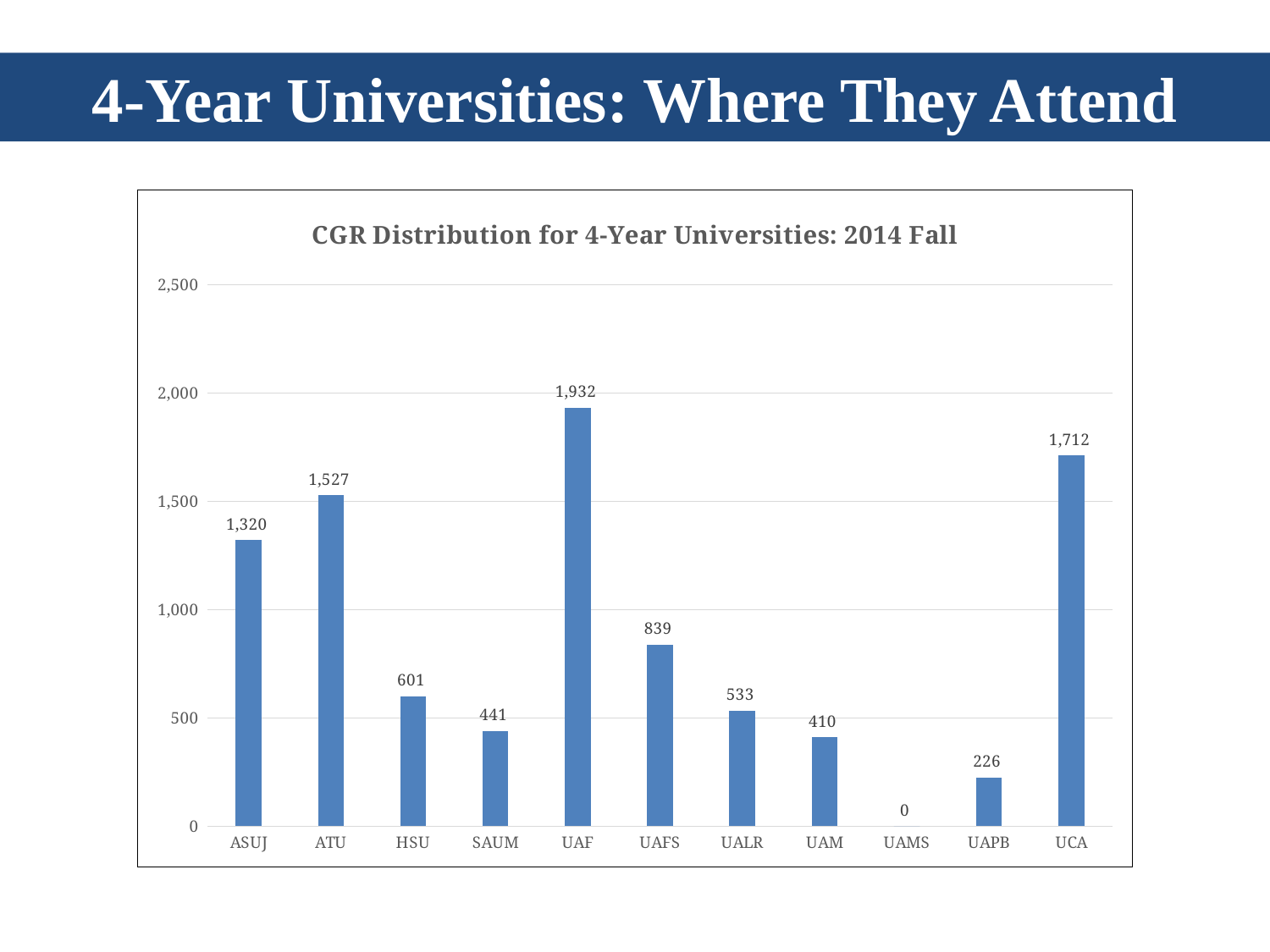
What kind of chart is shown? bar chart Which university has the highest value? UAF What is the value for SAUM? 441 What is the title of the chart? CGR Distribution for 4-Year Universities: 2014 Fall What is the difference between the values for ATU and ASUJ? 207 Which university has the lowest value? UAMS What is the difference between the values for UAF and UCA? 220 What is the value for UAF? 1,932 Is the value for UALR greater or less than 500? greater What is the value for UAPB? 226 Which is larger, the value for UAFS or the value for HSU? UAFS How many universities are shown on the x axis? 11